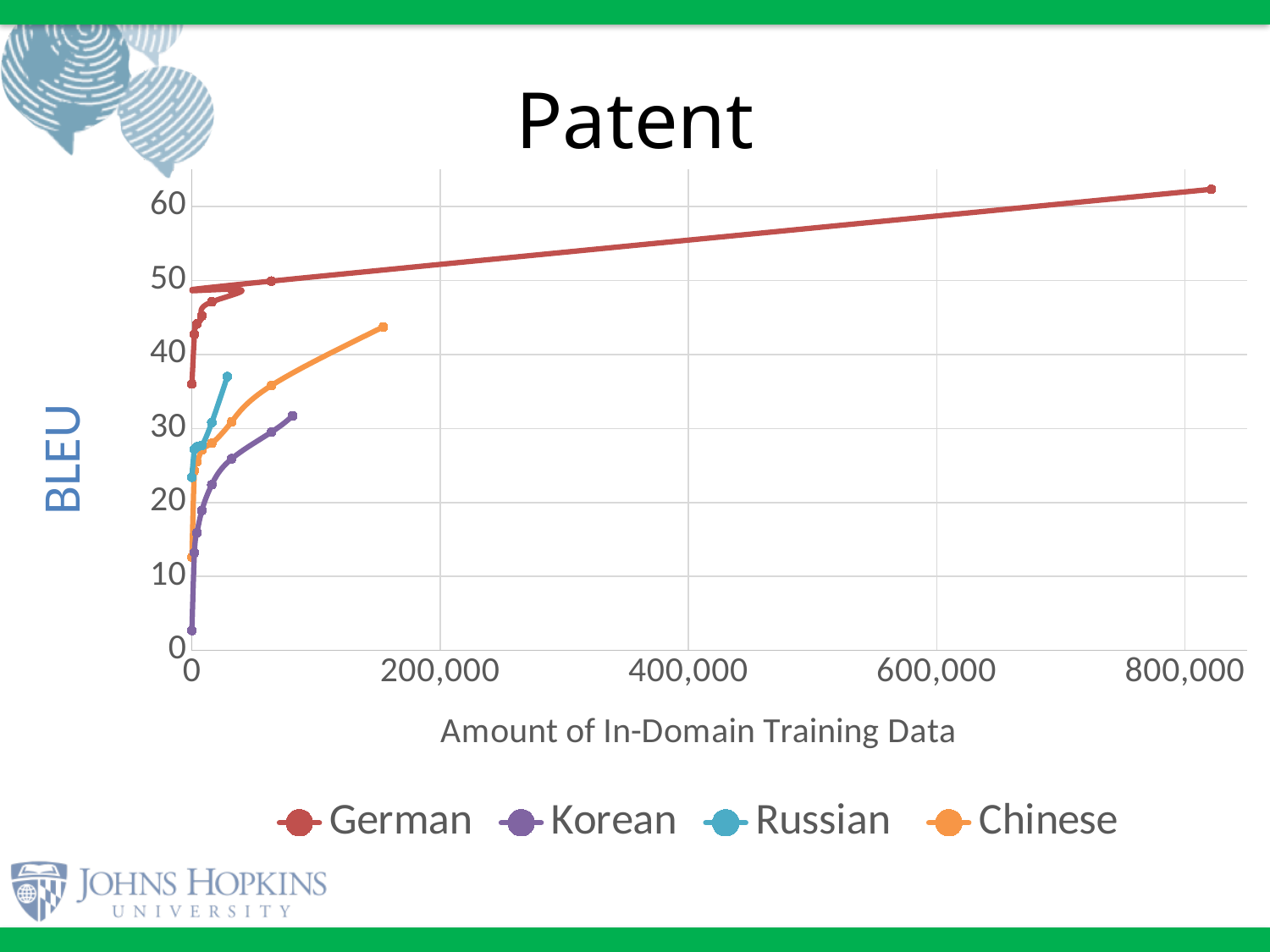
Is the highest BLEU value for Chinese greater or less than 40? greater Which series has the lowest maximum BLEU score? Korean Does the German BLEU score rise or fall as the amount of in-domain training data increases? rise How many series does the legend list? 4 Which series reaches a higher BLEU score at its largest amount of training data, Chinese or Korean? Chinese Is the highest BLEU value for Chinese greater or less than 50? less Which series reaches the highest BLEU score? German What kind of chart is shown on the slide? line chart Is the highest BLEU value for Korean greater or less than 40? less What is the label of the x axis? Amount of In-Domain Training Data What is the title of the chart? Patent